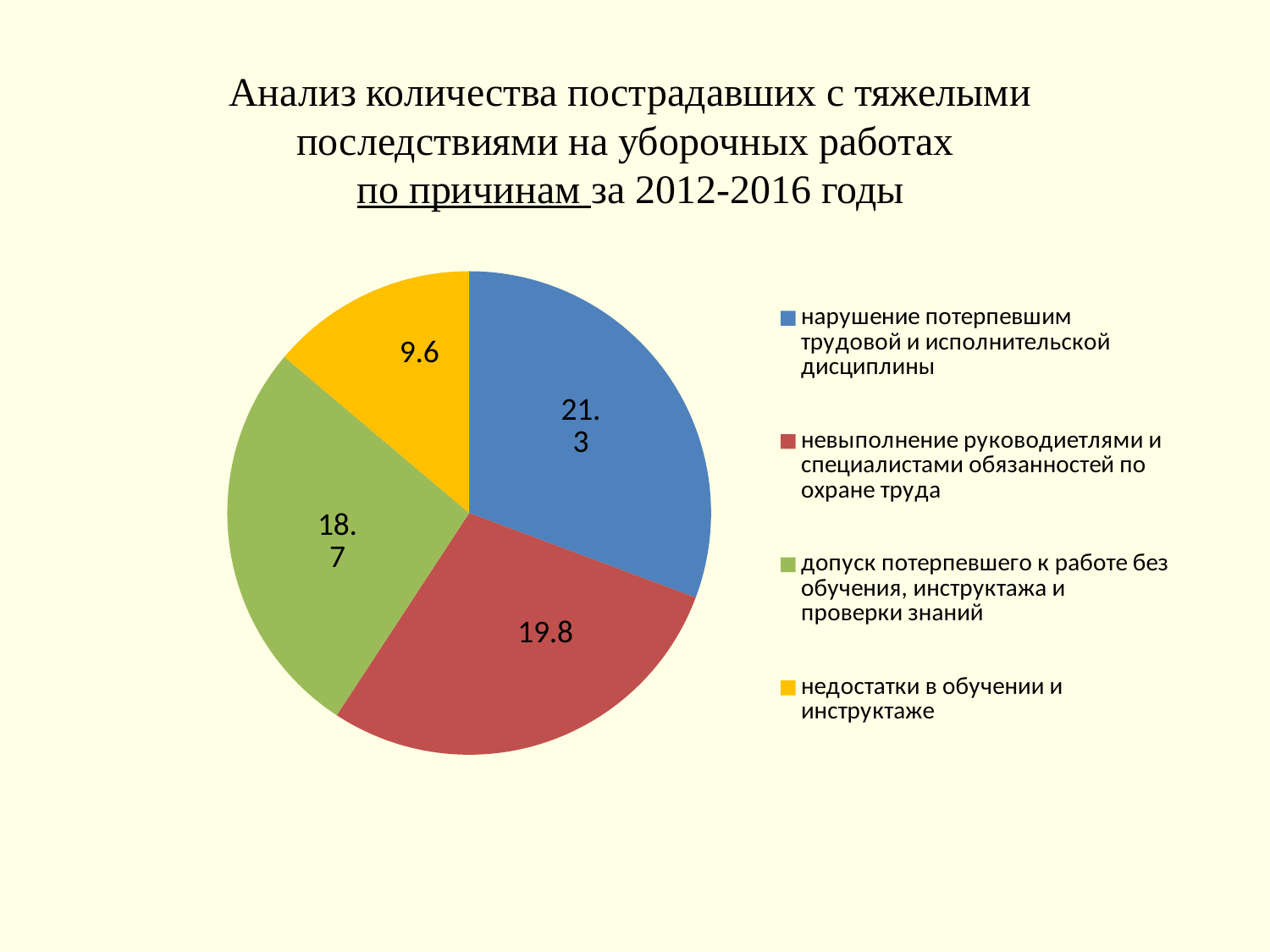
What is the value for the slice 'допуск потерпевшего к работе без обучения, инструктажа и проверки знаний'? 18.7 What is the difference between the values for 'нарушение потерпевшим трудовой и исполнительской дисциплины' and 'недостатки в обучении и инструктаже'? 11.7 Which cause has the largest slice of the pie? нарушение потерпевшим трудовой и исполнительской дисциплины What is the difference between the values for 'невыполнение руководиетлями и специалистами обязанностей по охране труда' and 'допуск потерпевшего к работе без обучения, инструктажа и проверки знаний'? 1.1 What kind of chart is shown on the slide? pie chart What is the value for the slice 'невыполнение руководиетлями и специалистами обязанностей по охране труда'? 19.8 How many slices does the pie chart have? 4 What colour is the slice for 'недостатки в обучении и инструктаже'? yellow What is the value for the slice 'недостатки в обучении и инструктаже'? 9.6 What is the value for the slice 'нарушение потерпевшим трудовой и исполнительской дисциплины'? 21.3 Which is larger: the value for 'нарушение потерпевшим трудовой и исполнительской дисциплины' or the value for 'невыполнение руководиетлями и специалистами обязанностей по охране труда'? нарушение потерпевшим трудовой и исполнительской дисциплины Which cause has the smallest slice of the pie? недостатки в обучении и инструктаже